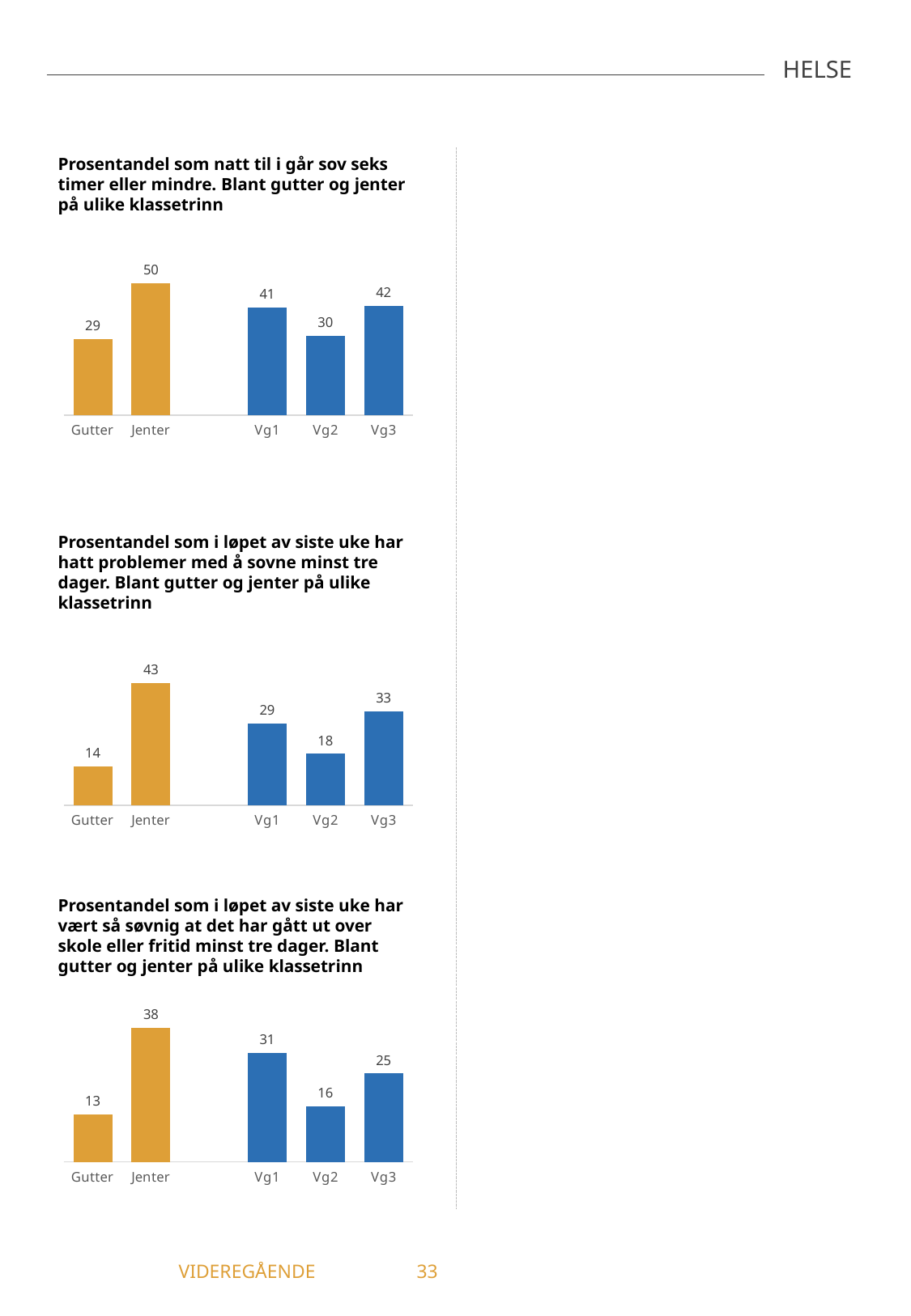
In the top chart (sov seks timer eller mindre), which category has the lowest value? Gutter In the bottom chart (så søvnig at det har gått ut over skole eller fritid), which category has the highest value? Jenter In the middle chart (problemer med å sovne), which is larger, Vg1 or Vg3? Vg3 In the bottom chart (så søvnig at det har gått ut over skole eller fritid), what is the value for Gutter? 13 In the top chart (sov seks timer eller mindre), what is the difference between Jenter and Gutter? 21 In the top chart (sov seks timer eller mindre), how many bars are plotted? 5 In the middle chart (problemer med å sovne), what is the difference between Vg3 and Vg2? 15 In the middle chart (problemer med å sovne), what is the value for Vg2? 18 What type of chart is the bottom chart on the slide? Bar chart In the bottom chart (så søvnig at det har gått ut over skole eller fritid), what is the difference between Vg1 and Vg2? 15 In the middle chart (problemer med å sovne), which category has the highest value? Jenter In the top chart (sov seks timer eller mindre), what is the value for Jenter? 50